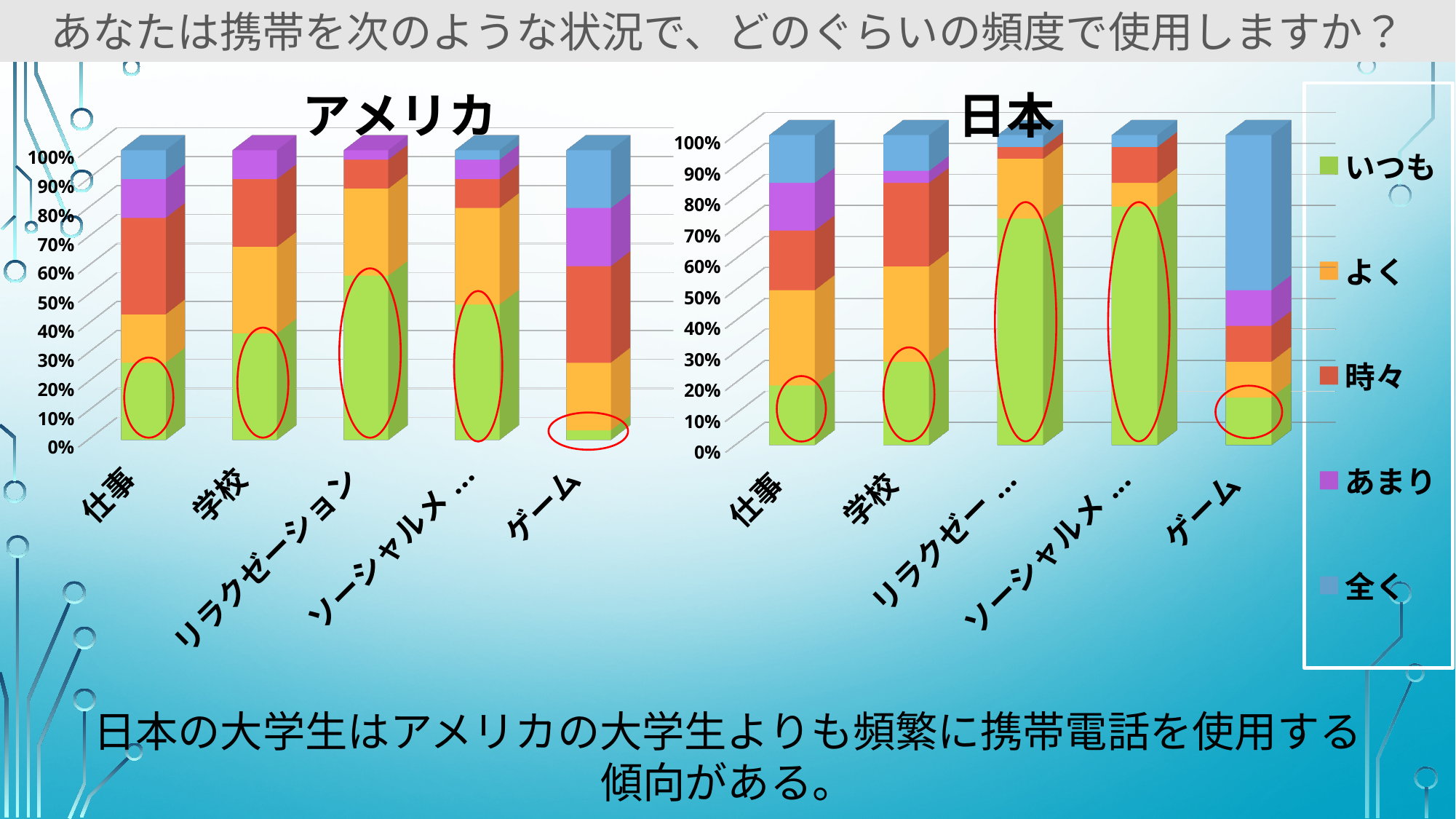
In the アメリカ chart, which category has the largest いつも segment? リラクゼーション In the アメリカ chart, which category has the smallest いつも segment? ゲーム In the 日本 chart, is the いつも value for 仕事 greater or less than 30%? less How many series does the legend list? 5 In the アメリカ chart, is the いつも value for ゲーム greater or less than 10%? less Which legend entry is shown in green? いつも In the 日本 chart, which has the larger いつも segment, 仕事 or 学校? 学校 What kind of chart is the アメリカ chart? stacked bar chart What are the titles of the two charts on the slide? アメリカ and 日本 How many categories are shown on the x axis of the 日本 chart? 5 In the アメリカ chart, is the いつも value for リラクゼーション greater or less than 50%? greater